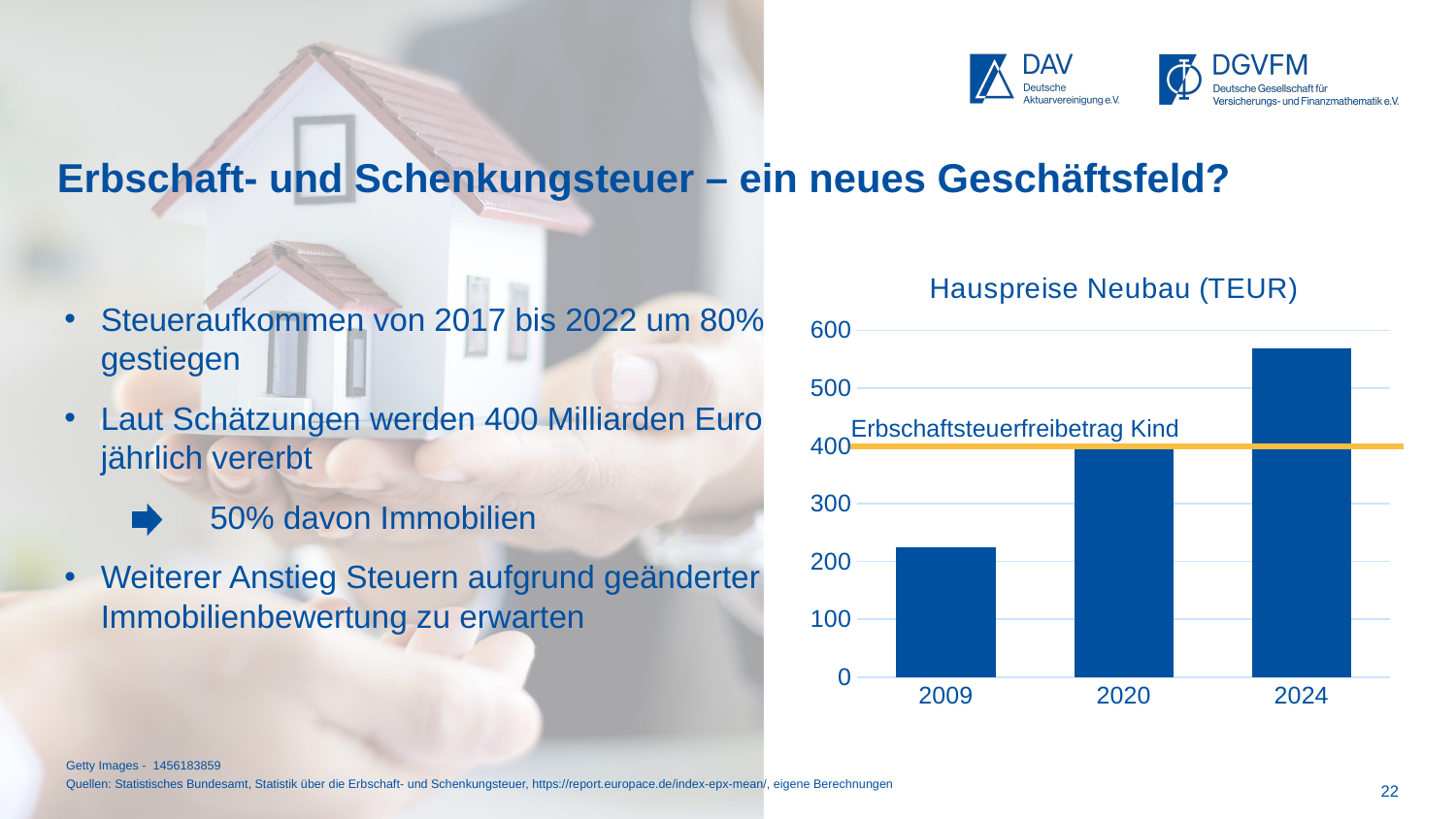
Which year has the highest house price in the chart? 2024 Is the value for 2009 greater or less than 200? greater Which is larger, the value for 2024 or the value for 2009? 2024 Is the value for 2009 greater or less than 300? less How many years are shown on the x axis of the chart? 3 Is the value for 2020 greater or less than 300? greater What kind of chart is shown on the slide? bar chart What is the title of the chart? Hauspreise Neubau (TEUR) Which year has the lowest house price in the chart? 2009 Do the house prices rise or fall from 2009 to 2024? rise What does the horizontal orange line in the chart represent? Erbschaftsteuerfreibetrag Kind